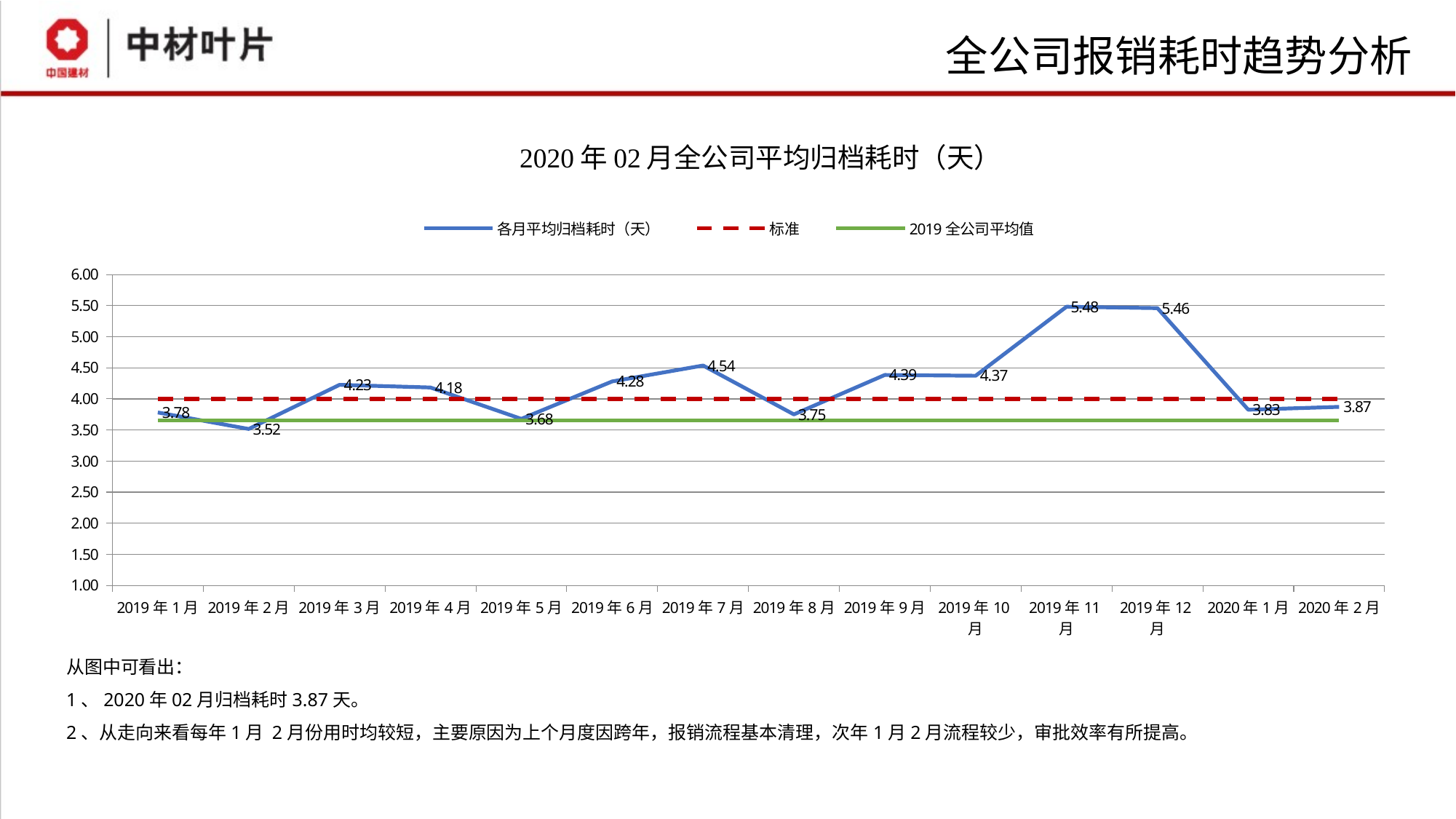
Which month has the lowest average filing time in the chart? 2019年2月 How many months are plotted on the x axis of the chart? 14 Which month has the highest average filing time in the chart? 2019年11月 What is the title of the chart? 2020年02月全公司平均归档耗时（天） What type of chart is shown on the slide? Line chart Which is larger, the value for 2019年3月 or the value for 2019年4月? 2019年3月 How many series does the chart legend list? 3 What is the difference between the values for 2019年11月 and 2019年12月? 0.02 Is the value for 2019年9月 greater or less than 4.00? greater What is the value for 2020年2月 in the chart? 3.87 What is the value for 2019年7月 in the chart? 4.54 What is the value for 2019年2月 in the chart? 3.52